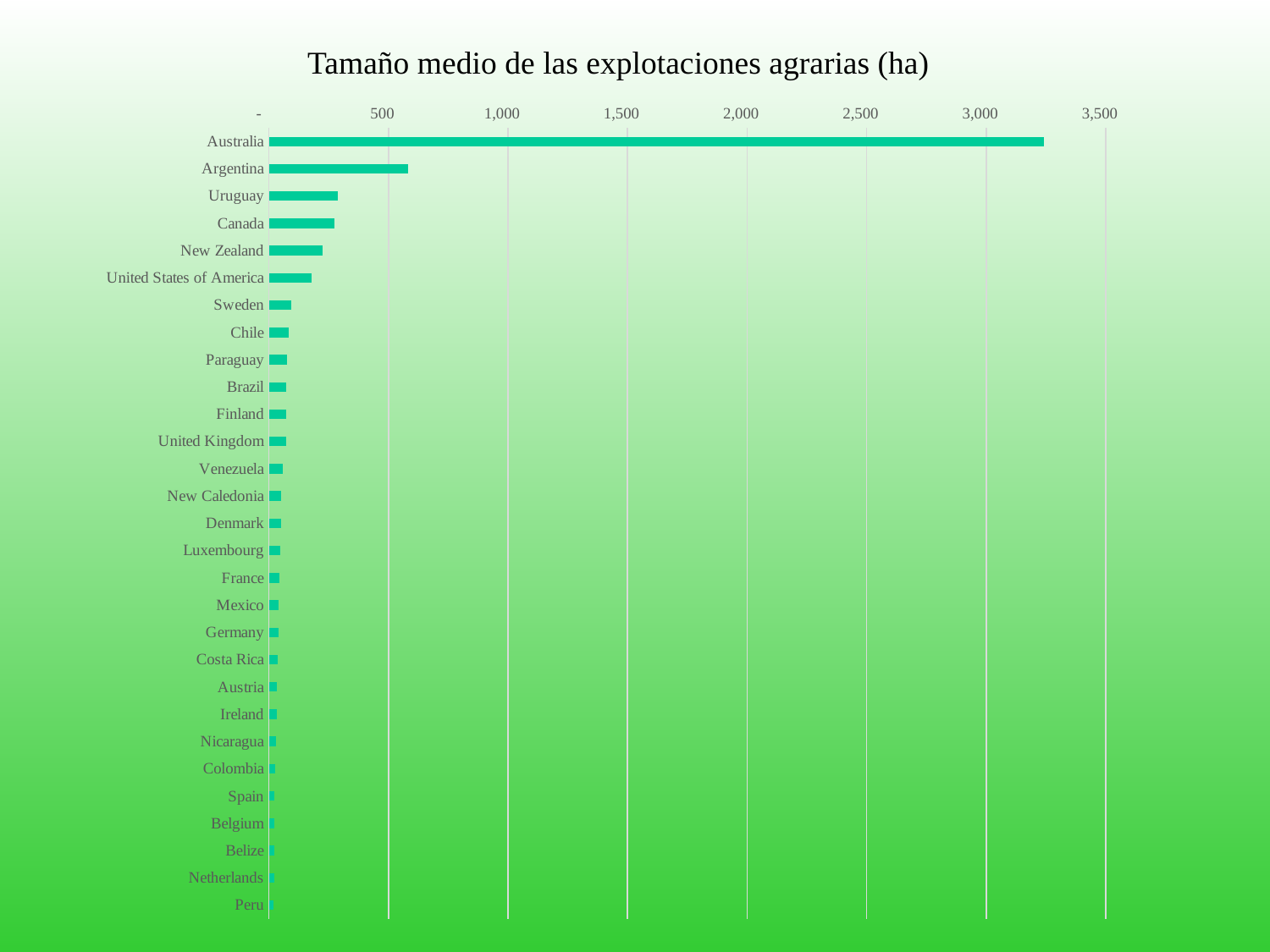
What kind of chart is shown on the slide? bar chart Is the value for Canada greater or less than 500? less Is the value for Uruguay greater or less than 500? less Is the value for Australia greater or less than 3,000? greater Do the bar values increase or decrease going from the top of the chart to the bottom? decrease How many countries are plotted in the chart? 29 Which country has the largest average farm size in the chart? Australia Which country has the smallest bar in the chart? Peru What is the title of the chart? Tamaño medio de las explotaciones agrarias (ha) Which has a larger value, Argentina or Uruguay? Argentina Which has a larger value, Sweden or Argentina? Argentina